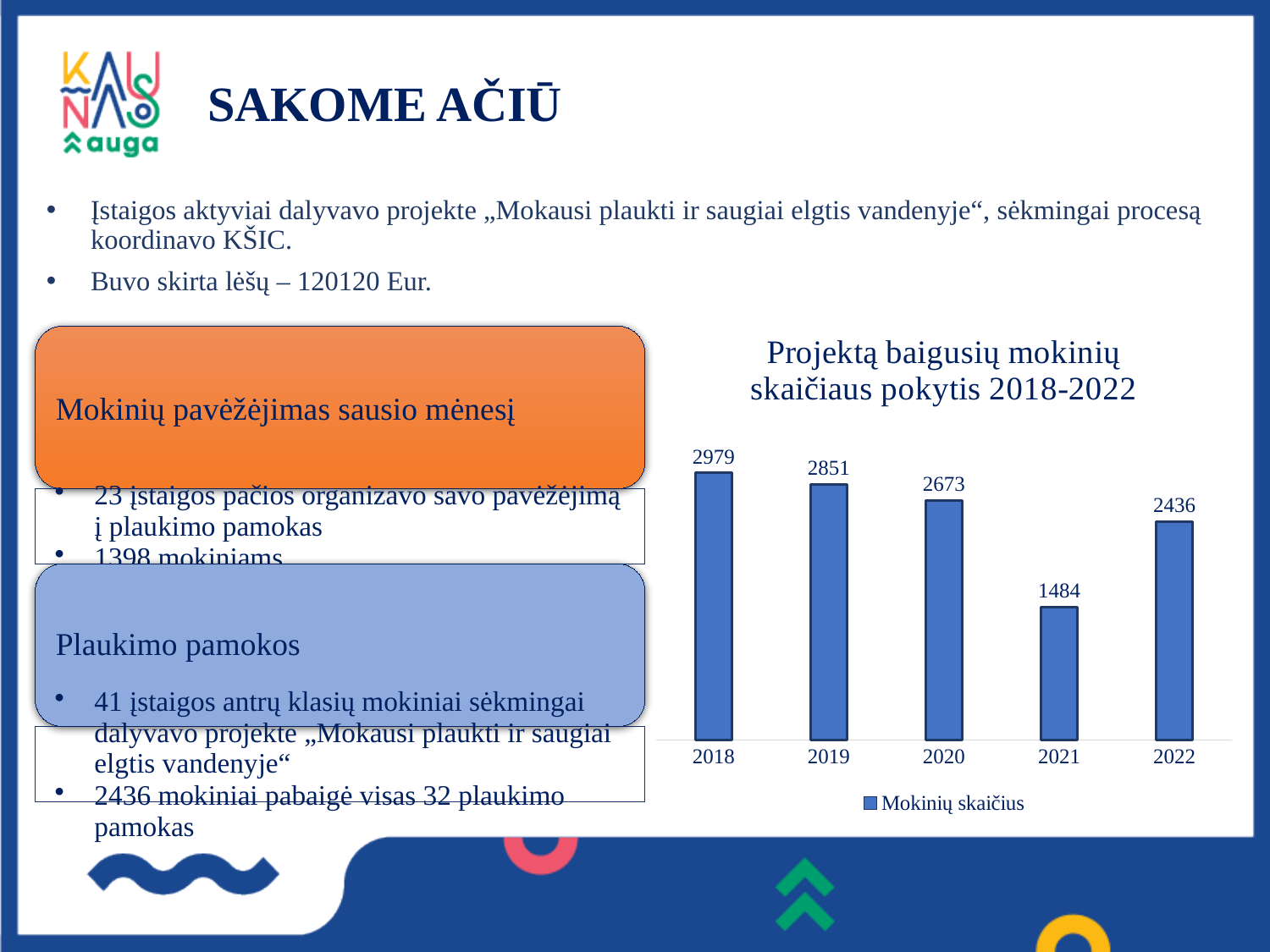
What is the difference between the values for 2022 and 2021? 952 What is the value for 2018 in the chart? 2979 Which is larger, the value for 2020 or the value for 2022? 2020 Which year has the highest value in the chart? 2018 Which year has the lowest value in the chart? 2021 What is the title of the chart? Projektą baigusių mokinių skaičiaus pokytis 2018-2022 How many years are shown on the x axis of the chart? 5 What is the difference between the values for 2018 and 2019? 128 What is the value for 2022 in the chart? 2436 What is the value for 2021 in the chart? 1484 What kind of chart is shown on the slide? bar chart How many series does the chart legend list? 1